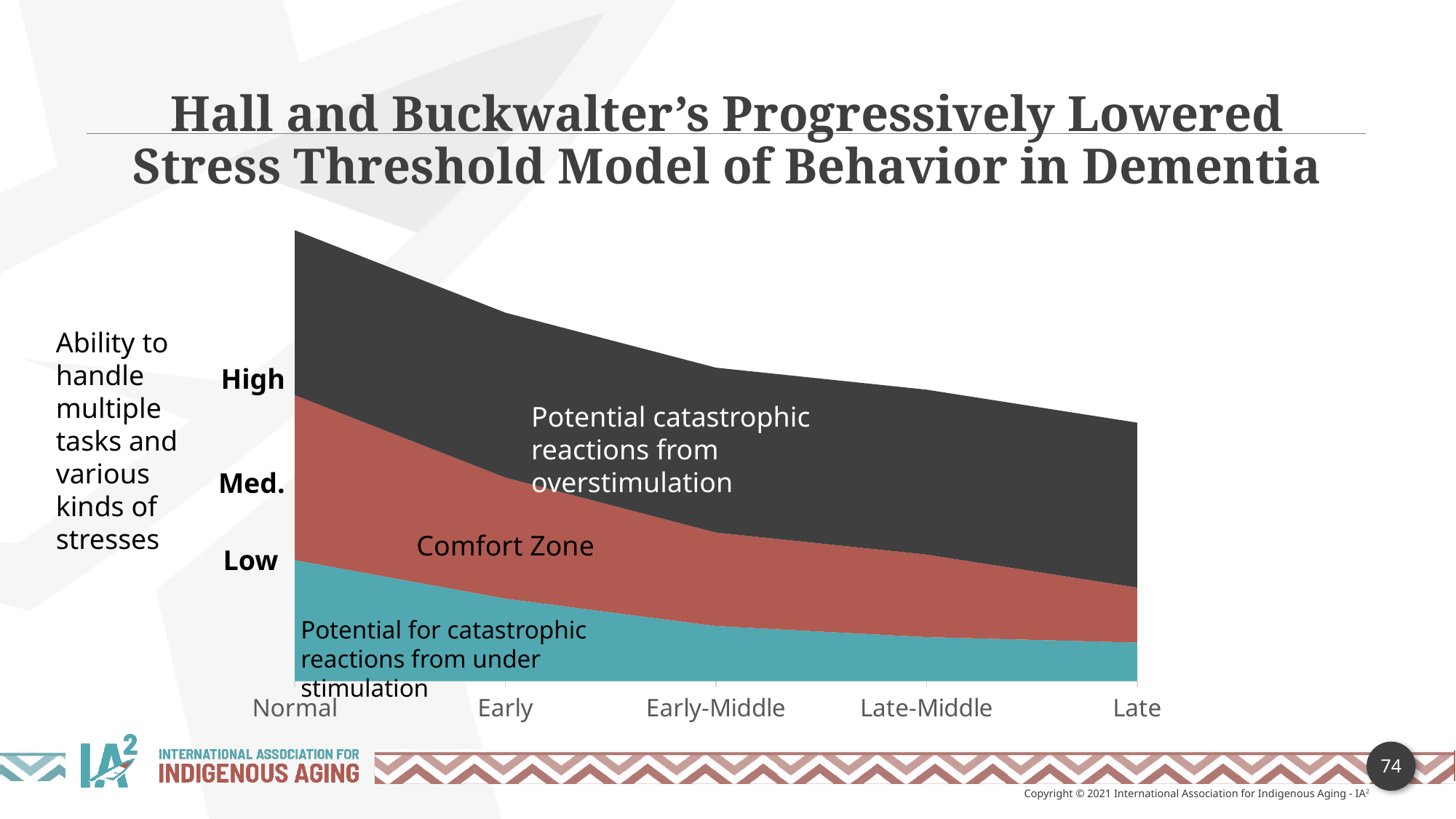
What are the three labels on the vertical axis, from top to bottom? High, Med., Low At which stage is the top of the stacked area lowest? Late What label is given to the middle (red) band of the chart? Comfort Zone Is the Comfort Zone band thicker at Normal or at Late? Normal How many stages are labeled along the x axis of the chart? 5 What are the stage labels along the x axis, from left to right? Normal, Early, Early-Middle, Late-Middle, Late At which stage is the top of the stacked area highest? Normal What kind of chart is shown on the slide? Area chart How many distinct bands (areas) are stacked in the chart? 3 Is the top of the stacked area higher at Normal or at Late? Normal Do the plotted areas rise or fall as the stages move from Normal to Late? Fall